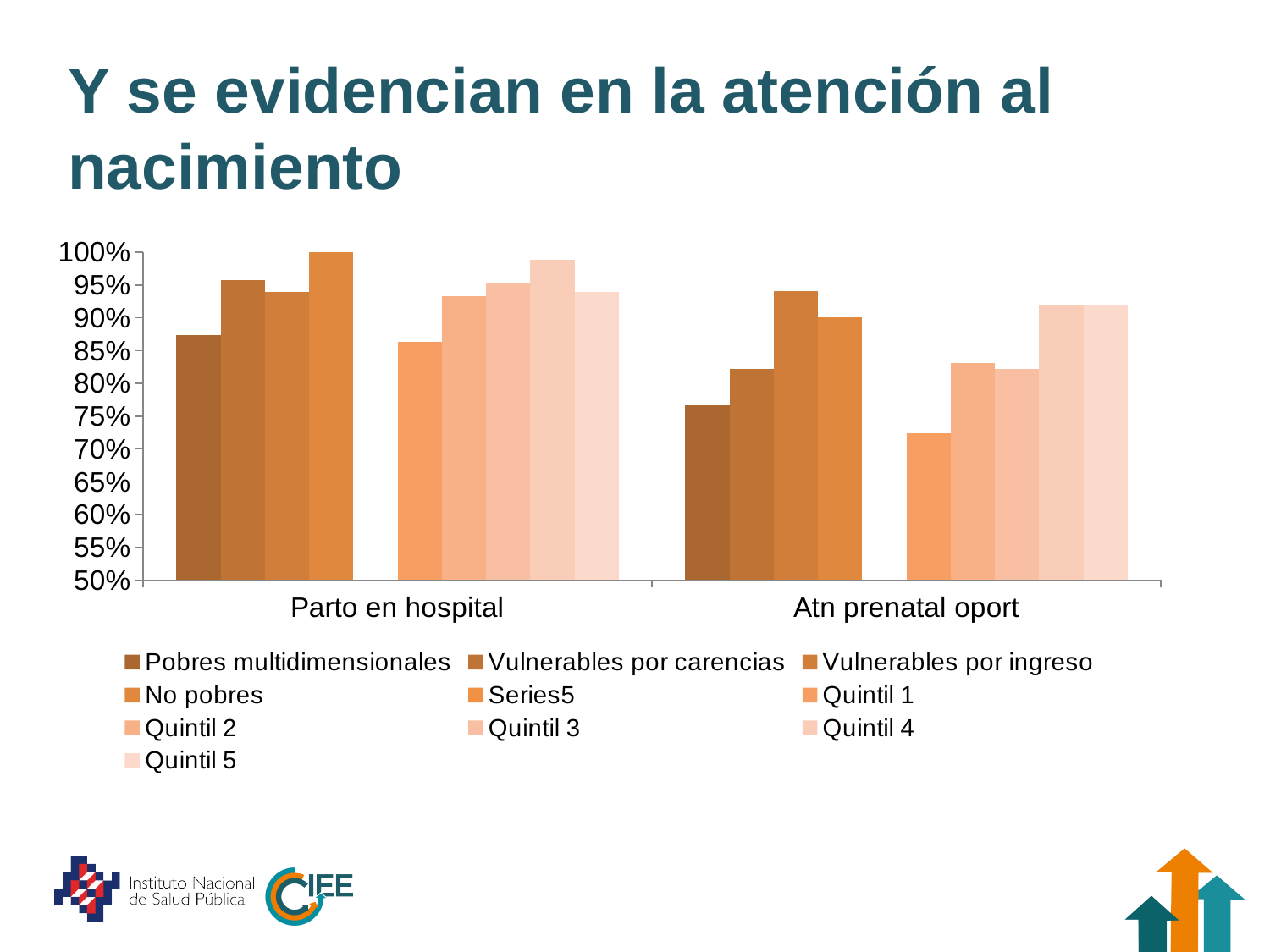
Which series has the lowest value in the Atn prenatal oport group? Quintil 1 Is the value for No pobres in the Atn prenatal oport group greater or less than 85%? greater For Pobres multidimensionales, which category has the larger value: Parto en hospital or Atn prenatal oport? Parto en hospital Is the value for Pobres multidimensionales in the Atn prenatal oport group greater or less than 80%? less In the Atn prenatal oport group, which is larger: Quintil 1 or Quintil 4? Quintil 4 Is the value for Quintil 4 in the Parto en hospital group greater or less than 95%? greater How many series does the chart legend list? 10 What kind of chart is shown on the slide? Bar chart Which series has the highest value in the Parto en hospital group? No pobres What is the title of the slide containing the chart? Y se evidencian en la atención al nacimiento How many categories are shown on the x axis of the chart? 2